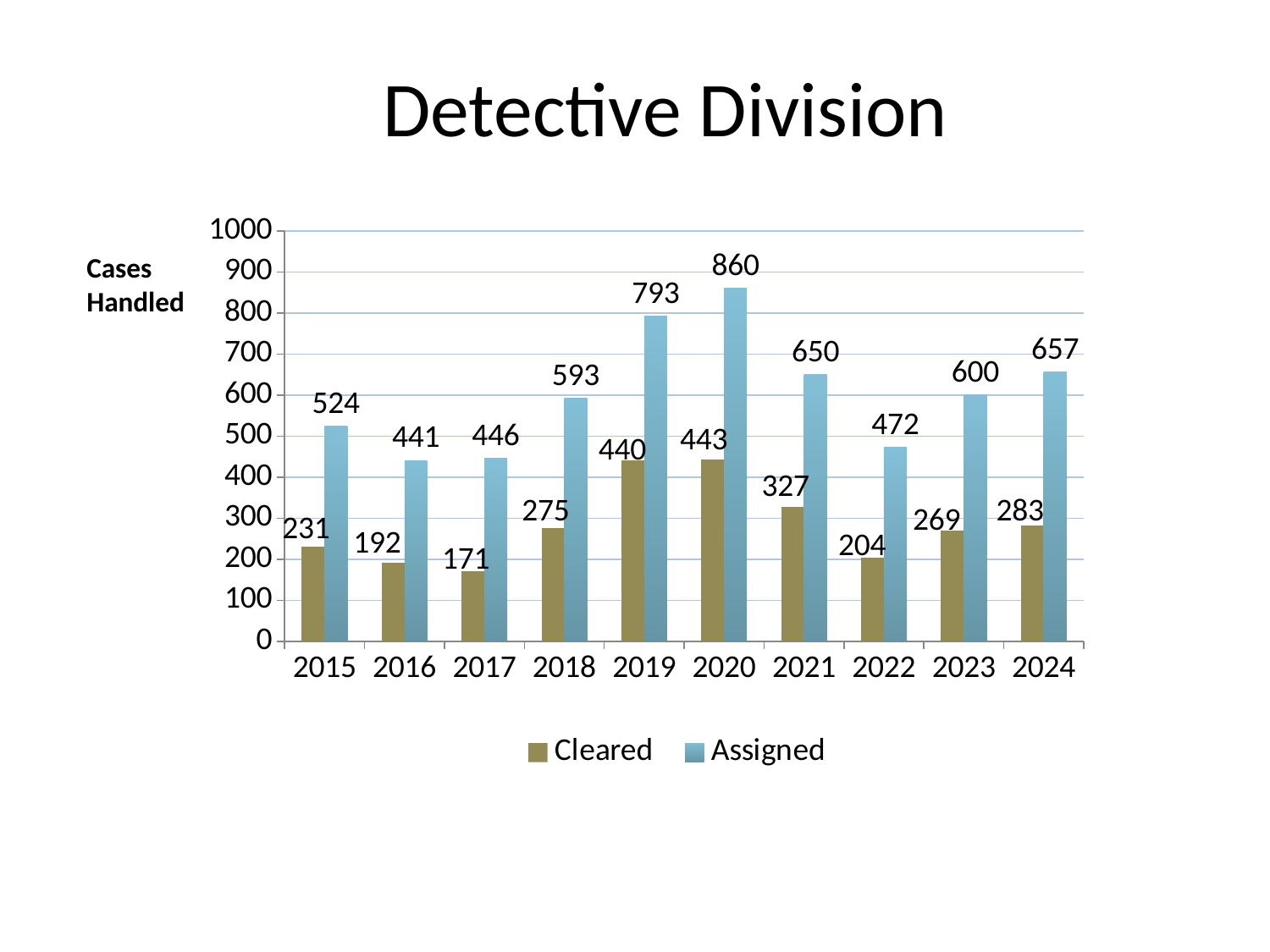
Do the Assigned cases rise or fall from 2021 to 2022? Fall How many years are shown on the x axis? 10 What kind of chart is shown on the slide? Bar chart What is the number of Cleared cases in 2017? 171 What is the difference between Assigned and Cleared cases in 2019? 353 Which year has the lowest number of Cleared cases? 2017 Which year has the highest number of Assigned cases? 2020 How many series does the legend list? 2 What is the number of Assigned cases in 2020? 860 Is the number of Assigned cases in 2023 greater or less than 500? greater Which is larger: Cleared cases in 2021 or Cleared cases in 2024? Cleared cases in 2021 What is the title of the slide? Detective Division